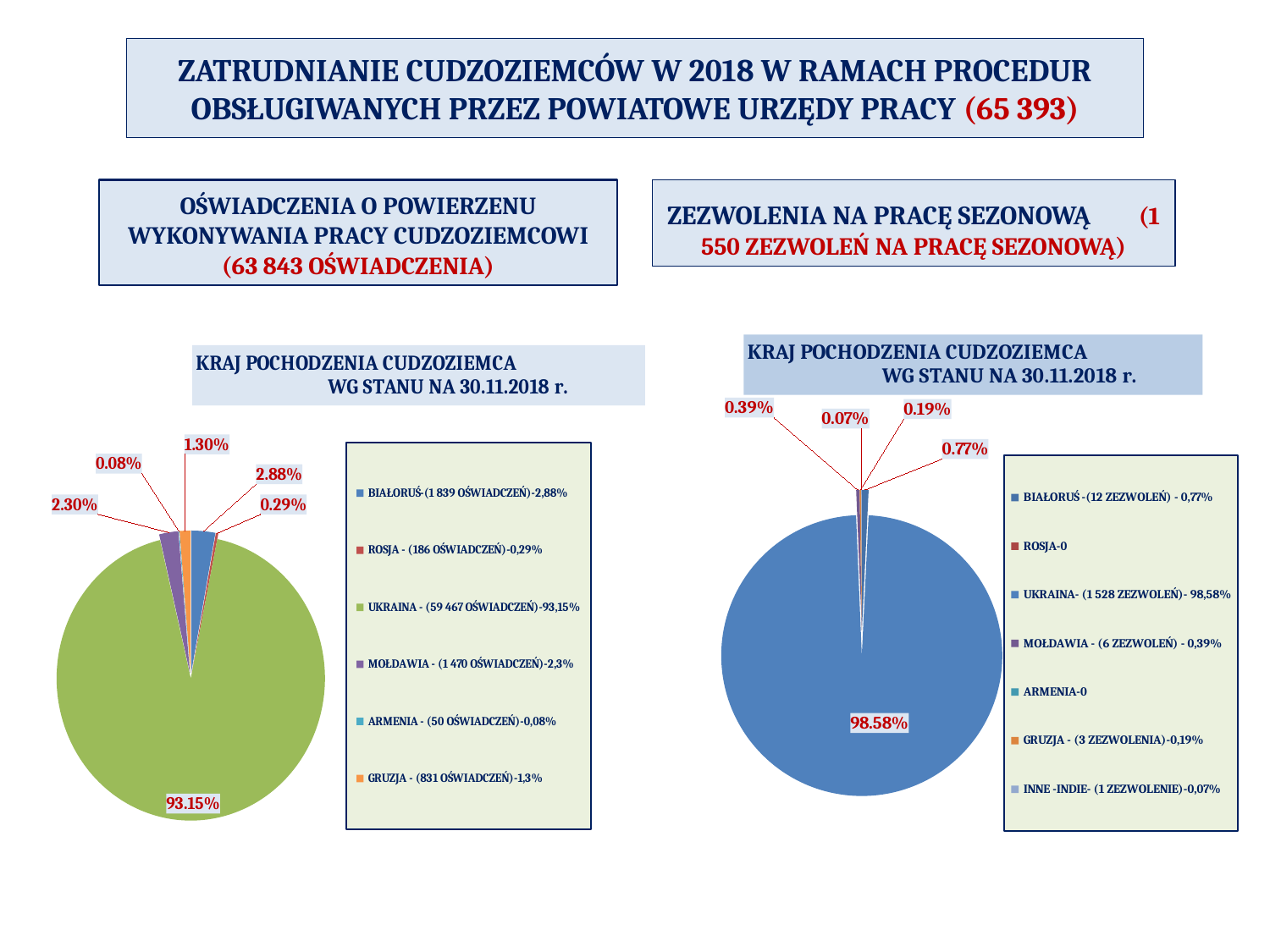
In the left pie chart (oświadczenia), which share is larger: Mołdawia or Gruzja? Mołdawia In the right pie chart (zezwolenia na pracę sezonową), which legend entries show a value of 0? Rosja and Armenia In the right pie chart (zezwolenia na pracę sezonową), how many zezwolenia does the legend give for Mołdawia? 6 In the right pie chart (zezwolenia na pracę sezonową), which country has the largest share? Ukraina What type of chart is used on the left side of the slide (oświadczenia)? pie chart In the left pie chart (oświadczenia), what is the difference in percentage points between Białoruś (2.88%) and Rosja (0.29%)? 2.59 In the left pie chart (oświadczenia), how many oświadczenia does the legend give for Białoruś? 1 839 In the left pie chart (oświadczenia), what share does Ukraina have? 93.15% In the left pie chart (oświadczenia), which country has the smallest share? Armenia In the left pie chart (oświadczenia), how many countries does the legend list? 6 In the right pie chart (zezwolenia na pracę sezonową), what share does Ukraina have? 98.58% In the right pie chart (zezwolenia na pracę sezonową), how many entries does the legend list? 7